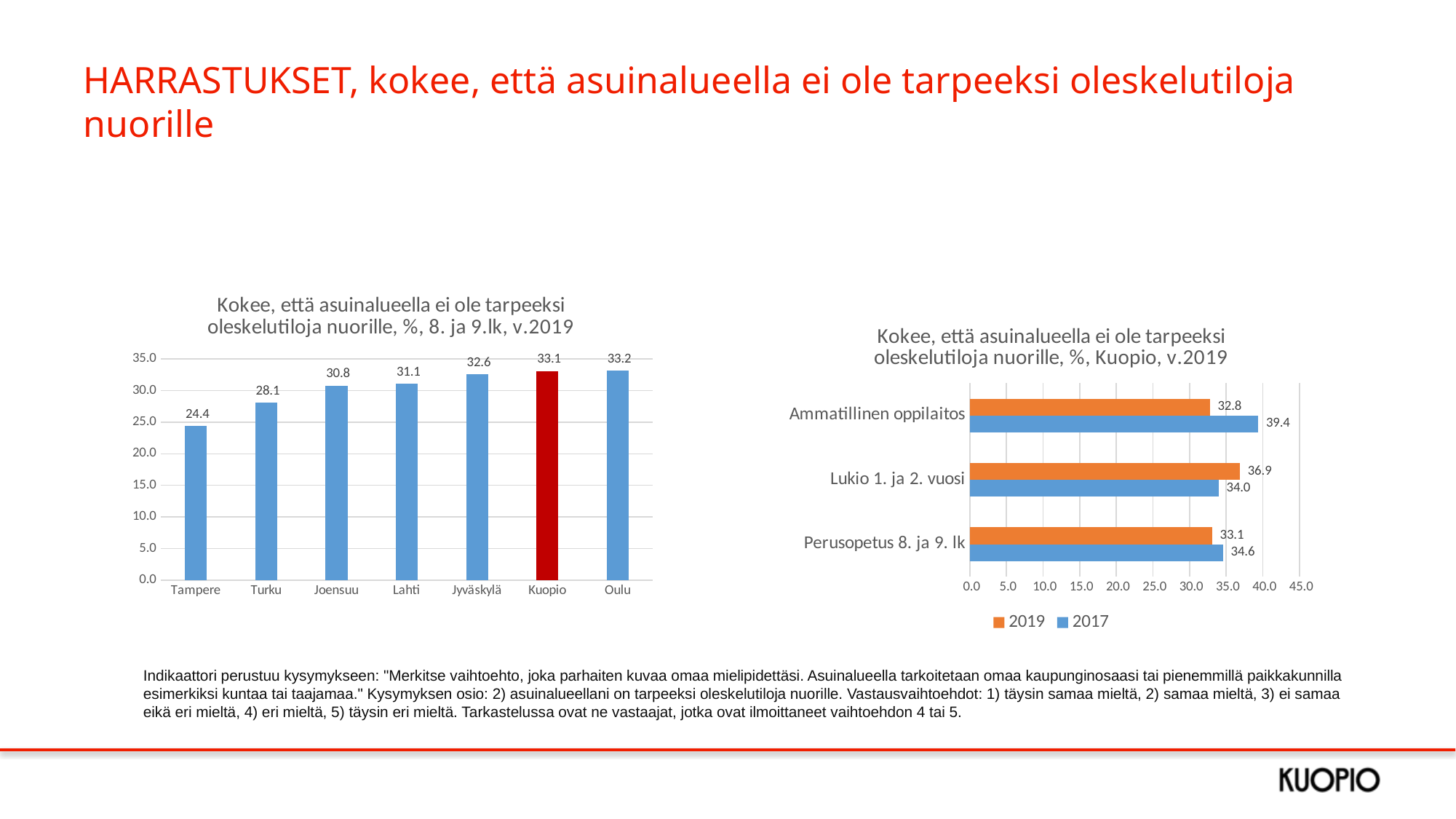
In the left chart (8. ja 9.lk, v.2019), how many cities are shown? 7 In the right chart (Kuopio, v.2019), what is the 2017 value for Ammatillinen oppilaitos? 39.4 In the left chart (8. ja 9.lk, v.2019), what is the difference between Oulu and Tampere? 8.8 In the right chart (Kuopio, v.2019), which is larger for Perusopetus 8. ja 9. lk: the 2019 value or the 2017 value? 2017 In the left chart (8. ja 9.lk, v.2019), what is the value for Kuopio? 33.1 In the left chart (8. ja 9.lk, v.2019), which bar is coloured red? Kuopio In the left chart (8. ja 9.lk, v.2019), what is the value for Tampere? 24.4 What kind of chart is the left chart (8. ja 9.lk, v.2019)? bar chart In the left chart (8. ja 9.lk, v.2019), do the values rise or fall from Tampere to Oulu? rise In the left chart (8. ja 9.lk, v.2019), which city has the lowest value? Tampere In the right chart (Kuopio, v.2019), how many series does the legend list? 2 In the right chart (Kuopio, v.2019), what is the 2019 value for Lukio 1. ja 2. vuosi? 36.9